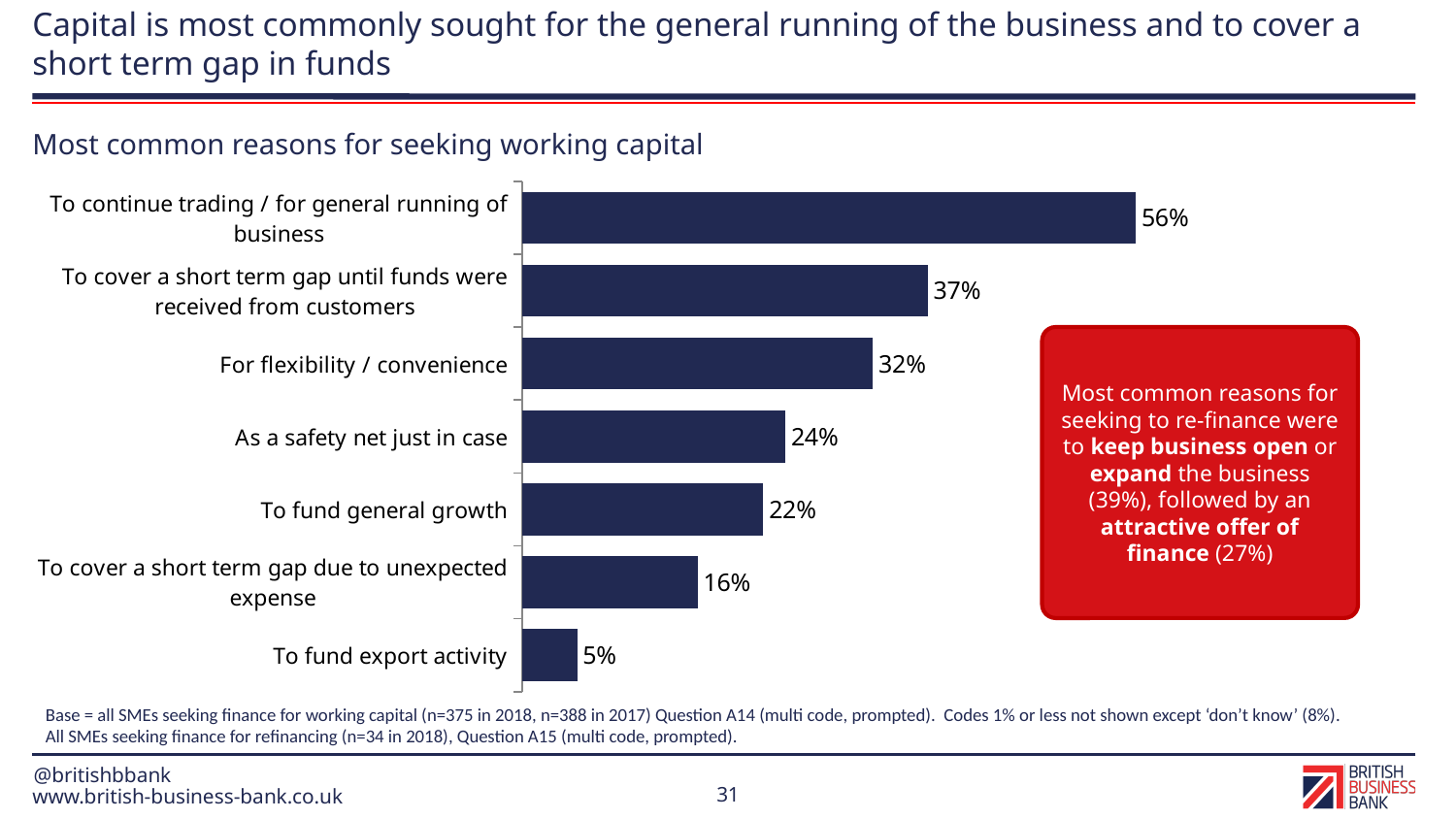
Do the values rise or fall going from the top bar to the bottom bar? Fall Which reason for seeking working capital has the lowest percentage? To fund export activity What percentage cited 'As a safety net just in case' as a reason for seeking working capital? 24% What is the difference in percentage points between 'To cover a short term gap due to unexpected expense' and 'To fund export activity'? 11 percentage points What is the difference in percentage points between 'To continue trading / for general running of business' and 'To cover a short term gap until funds were received from customers'? 19 percentage points What percentage of SMEs sought working capital to continue trading / for general running of business? 56% What type of chart is used to show the most common reasons for seeking working capital? Bar chart What is the value for 'To fund export activity'? 5% Which reason for seeking working capital has the highest percentage? To continue trading / for general running of business What is the title of the chart? Most common reasons for seeking working capital How many reasons for seeking working capital are shown in the chart? 7 Which is larger: the value for 'For flexibility / convenience' or the value for 'To fund general growth'? For flexibility / convenience